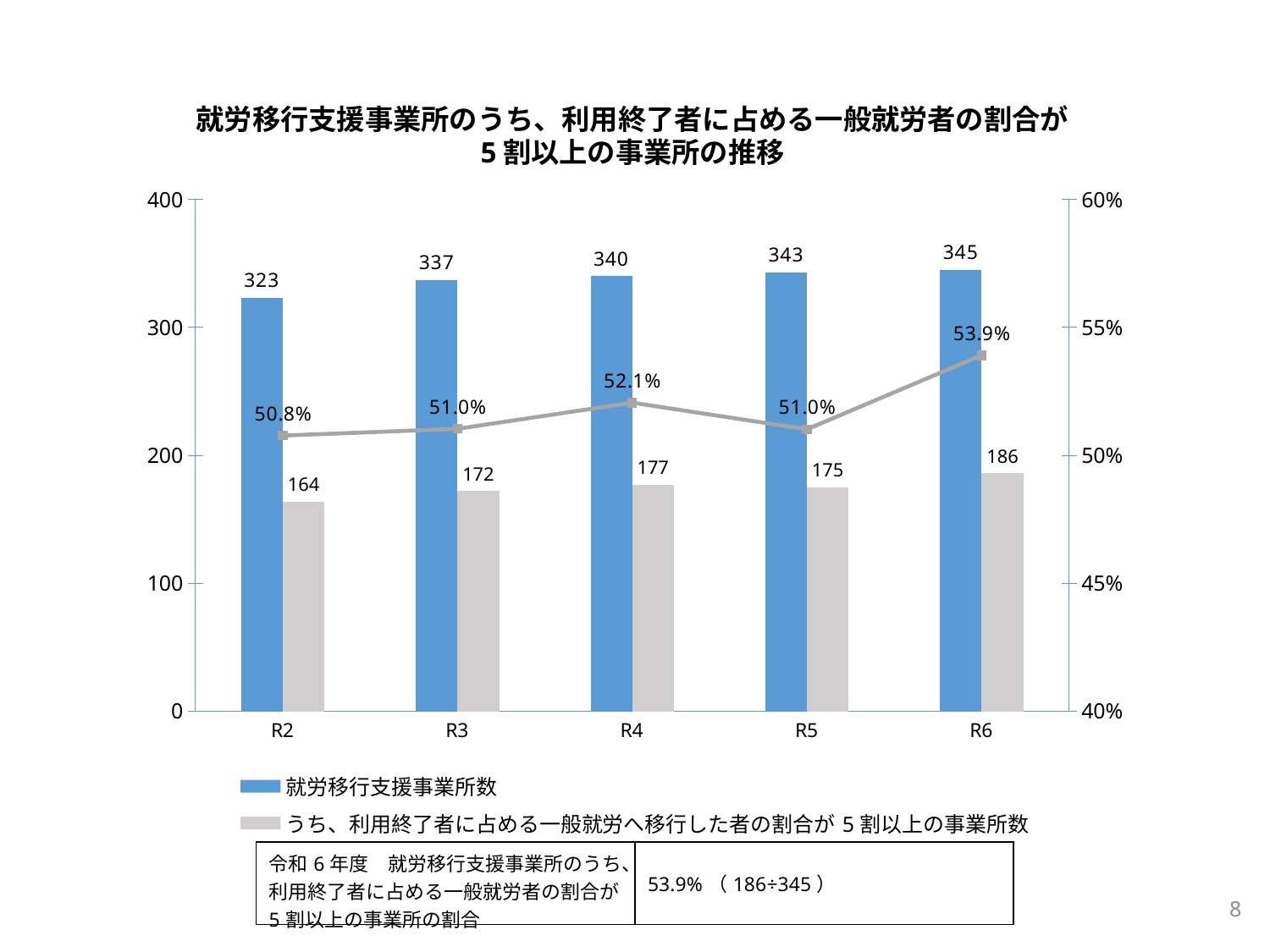
Which is larger: うち、利用終了者に占める一般就労へ移行した者の割合が5割以上の事業所数 in R4 or in R5? R4 What is the difference between 就労移行支援事業所数 in R6 and R2? 22 Is the value of 就労移行支援事業所数 for R3 greater or less than 300? greater How many series does the legend list? 2 What percentage is shown on the line for R4? 52.1% What is the value of 就労移行支援事業所数 for R2? 323 Does 就労移行支援事業所数 rise or fall from R2 to R6? rise In which year is うち、利用終了者に占める一般就労へ移行した者の割合が5割以上の事業所数 lowest? R2 How many years are shown on the x axis? 5 What is the value of うち、利用終了者に占める一般就労へ移行した者の割合が5割以上の事業所数 for R6? 186 What kind of chart is this? Bar chart with a line In which year is 就労移行支援事業所数 highest? R6